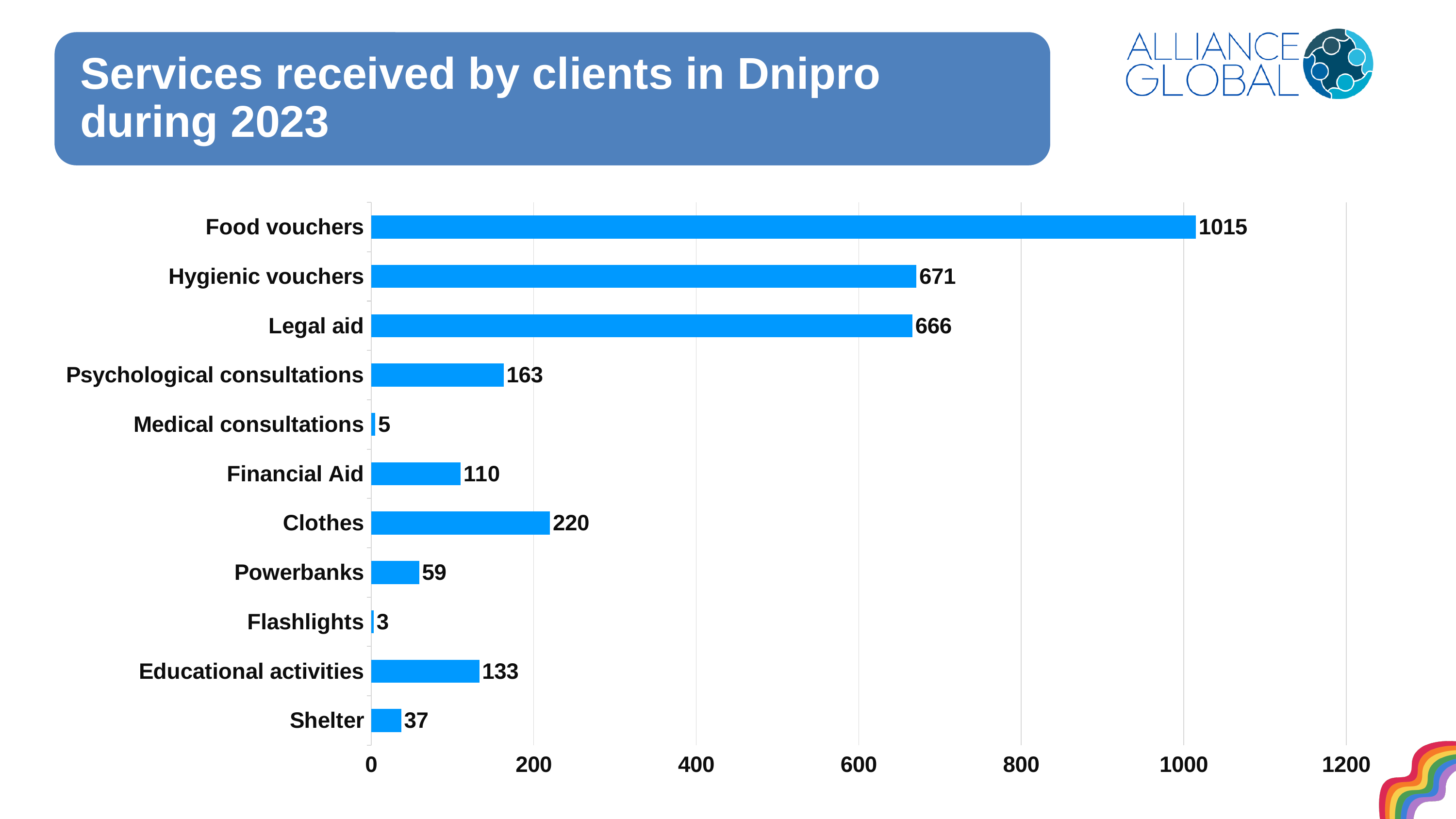
Which category has the highest value? Food vouchers Which is larger, Educational activities or Powerbanks? Educational activities What is the value for Psychological consultations? 163 Is the value for Clothes greater or less than 200? greater What is the value for Shelter? 37 How many categories are shown in the chart? 11 What kind of chart is shown on the slide? Bar chart What is the difference between Clothes and Financial Aid? 110 Which category has the lowest value? Flashlights What is the value for Food vouchers? 1015 What is the title of the slide? Services received by clients in Dnipro during 2023 What is the difference between Hygienic vouchers and Legal aid? 5